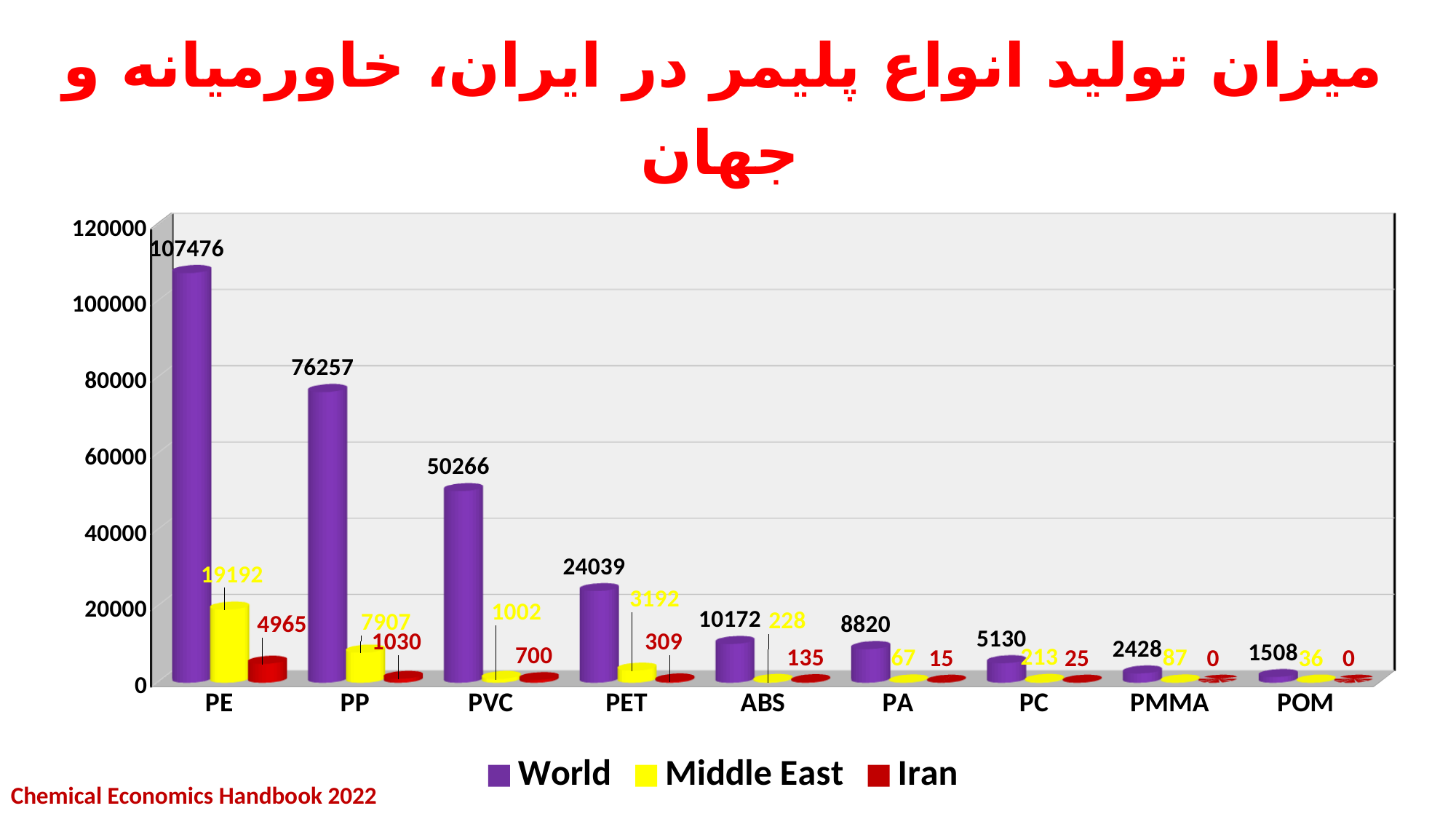
Is the World value for PVC greater or less than 40000? greater What is the Middle East value for PP? 7907 What is the difference between the World values for PE and PP? 31219 Which is larger for PET: the Middle East value or the Iran value? Middle East Do the World values rise or fall moving from PE to POM along the x axis? fall How many polymer categories are shown on the x axis? 9 What is the Iran value for PVC? 700 How many series does the legend list? 3 What kind of chart is shown on the slide? bar chart Which polymer has the highest World value? PE Which polymer has the lowest World value? POM What is the World production value for PE? 107476